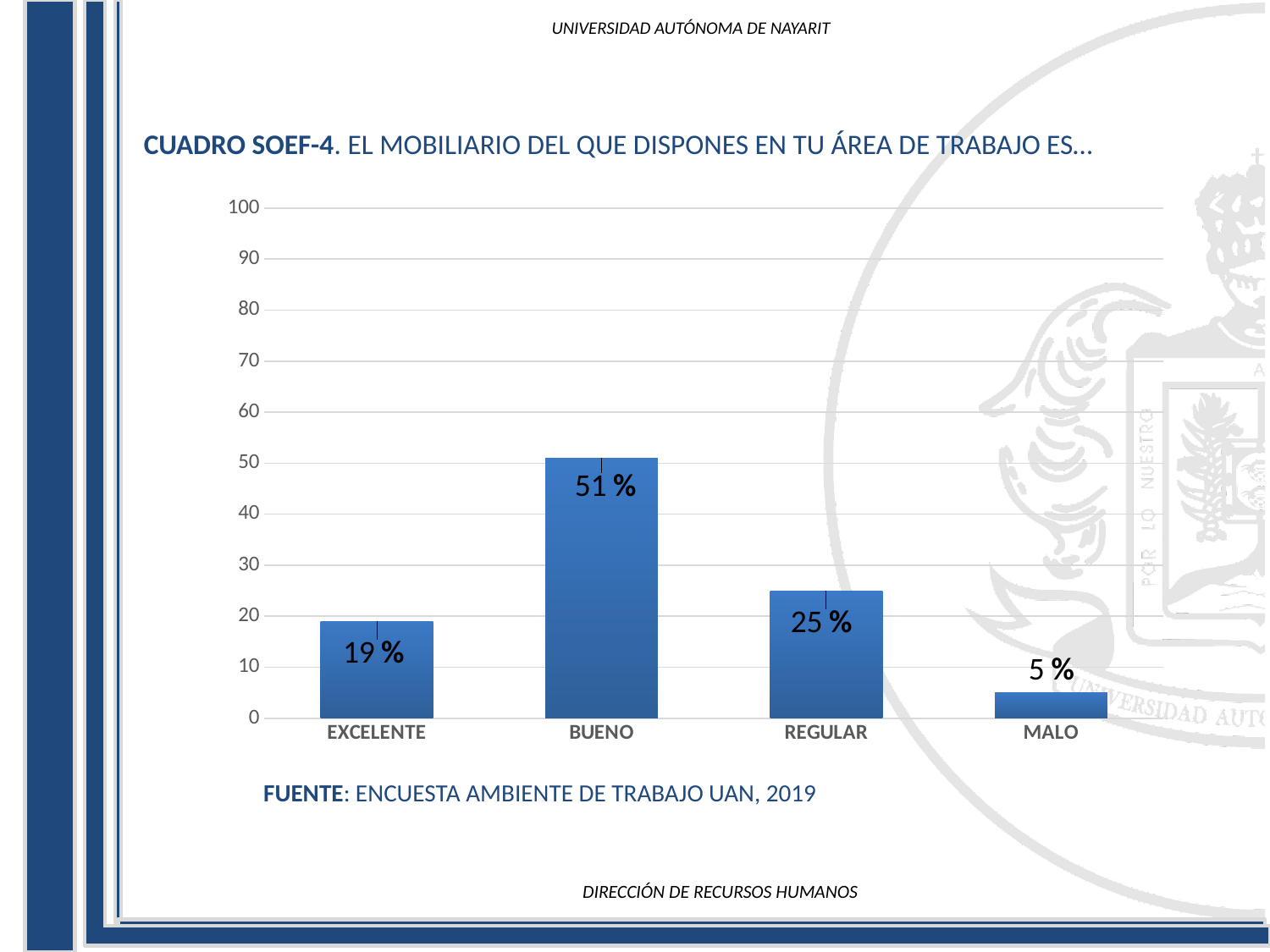
Which category has the lowest value? MALO Is the value for BUENO greater or less than 50? greater Which category has the highest value? BUENO What is the value for REGULAR? 25 % What kind of chart is shown on the slide? bar chart How many categories are shown on the x axis? 4 What is the value for MALO? 5 % What source is cited below the chart? ENCUESTA AMBIENTE DE TRABAJO UAN, 2019 What is the value for BUENO? 51 % What is the difference between the values for BUENO and REGULAR? 26 % Which is larger, the value for EXCELENTE or the value for REGULAR? REGULAR What is the value for EXCELENTE? 19 %